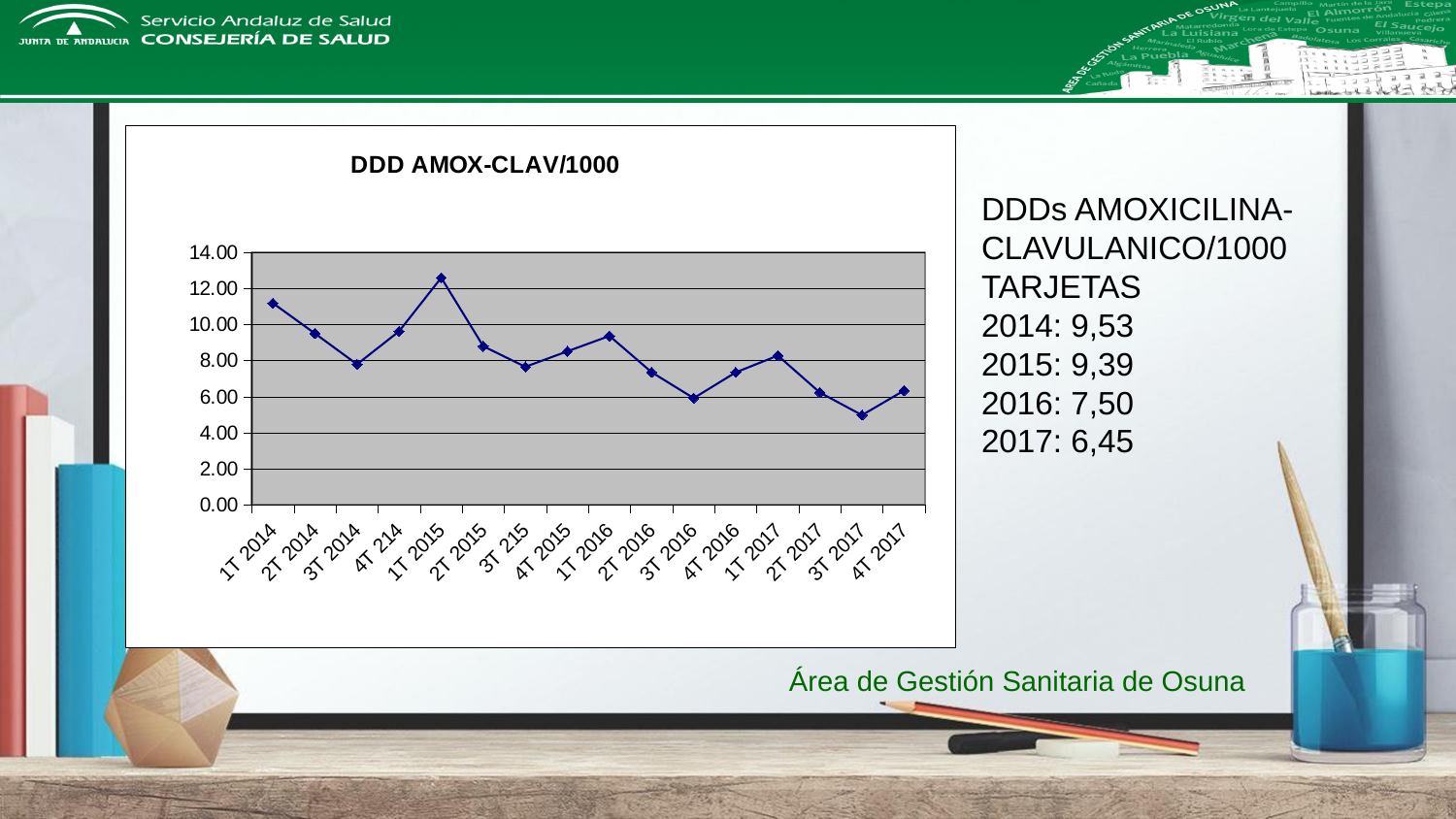
Which is larger, the value for 1T 2014 or the value for 4T 2017? 1T 2014 Is the value for 1T 2015 greater or less than 12.00? greater Is the value for 3T 2017 greater or less than 6.00? less Is the value for 2T 2016 greater or less than 8.00? less What is the title of the chart? DDD AMOX-CLAV/1000 Which quarter has the highest value on the chart? 1T 2015 How many data points are plotted on the chart? 16 Which quarter has the lowest value on the chart? 3T 2017 What kind of chart is shown on the slide? Line chart Which is larger, the value for 1T 2015 or the value for 2T 2015? 1T 2015 Overall, do the values rise or fall from 1T 2014 to 4T 2017? Fall